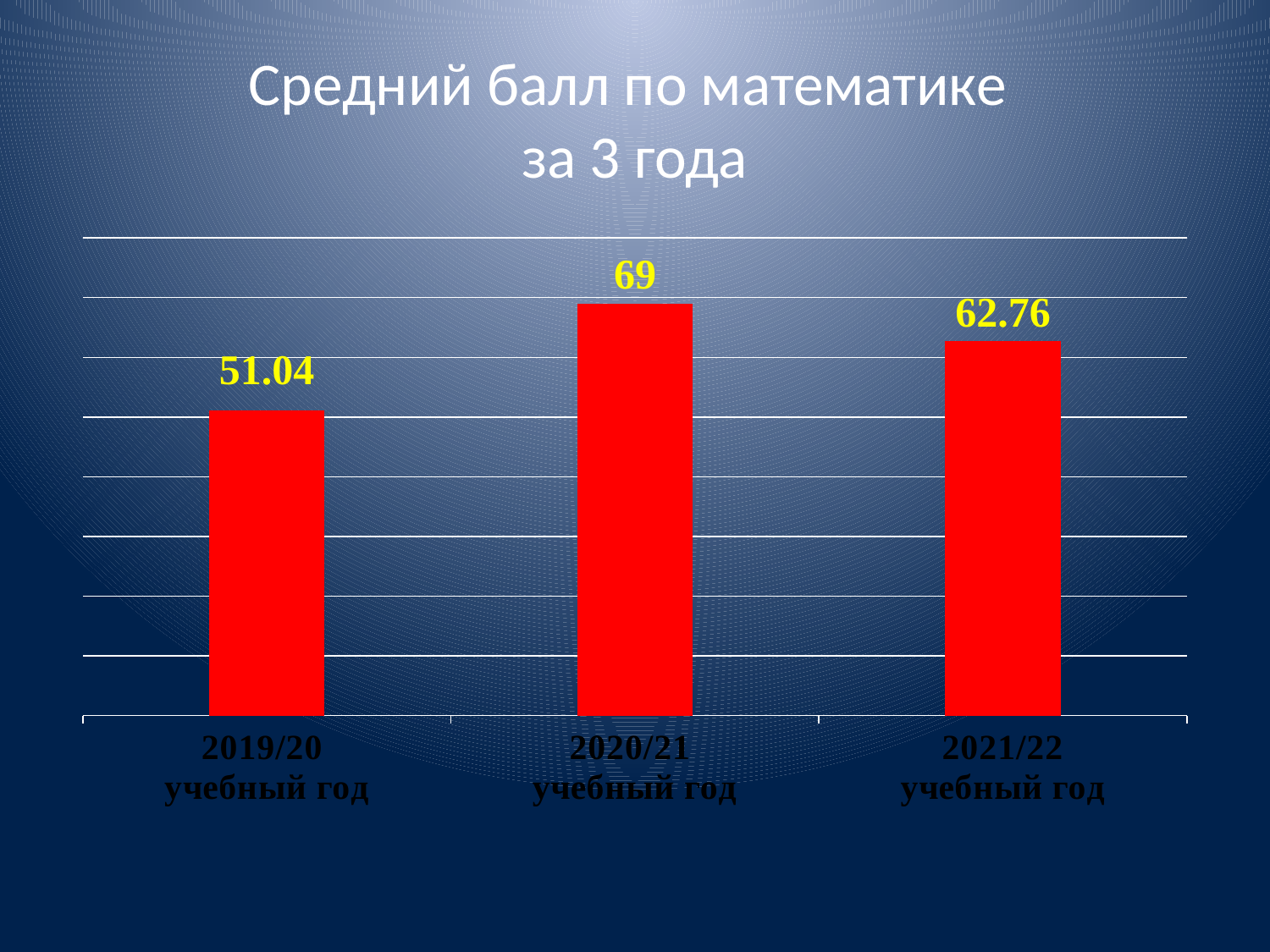
How many academic years are shown in the chart? 3 Which academic year has the highest average math score? 2020/21 учебный год Which academic year has the lowest average math score? 2019/20 учебный год What is the title of the chart on the slide? Средний балл по математике за 3 года What is the average math score for the 2019/20 учебный год? 51.04 What is the average math score for the 2021/22 учебный год? 62.76 Does the average math score rise or fall from 2020/21 to 2021/22? Fall What kind of chart is shown on the slide? Bar chart What is the average math score for the 2020/21 учебный год? 69 What is the difference between the average math scores for 2020/21 and 2021/22? 6.24 Which is larger, the average math score for 2021/22 or for 2019/20? 2021/22 учебный год What is the difference between the average math scores for 2020/21 and 2019/20? 17.96